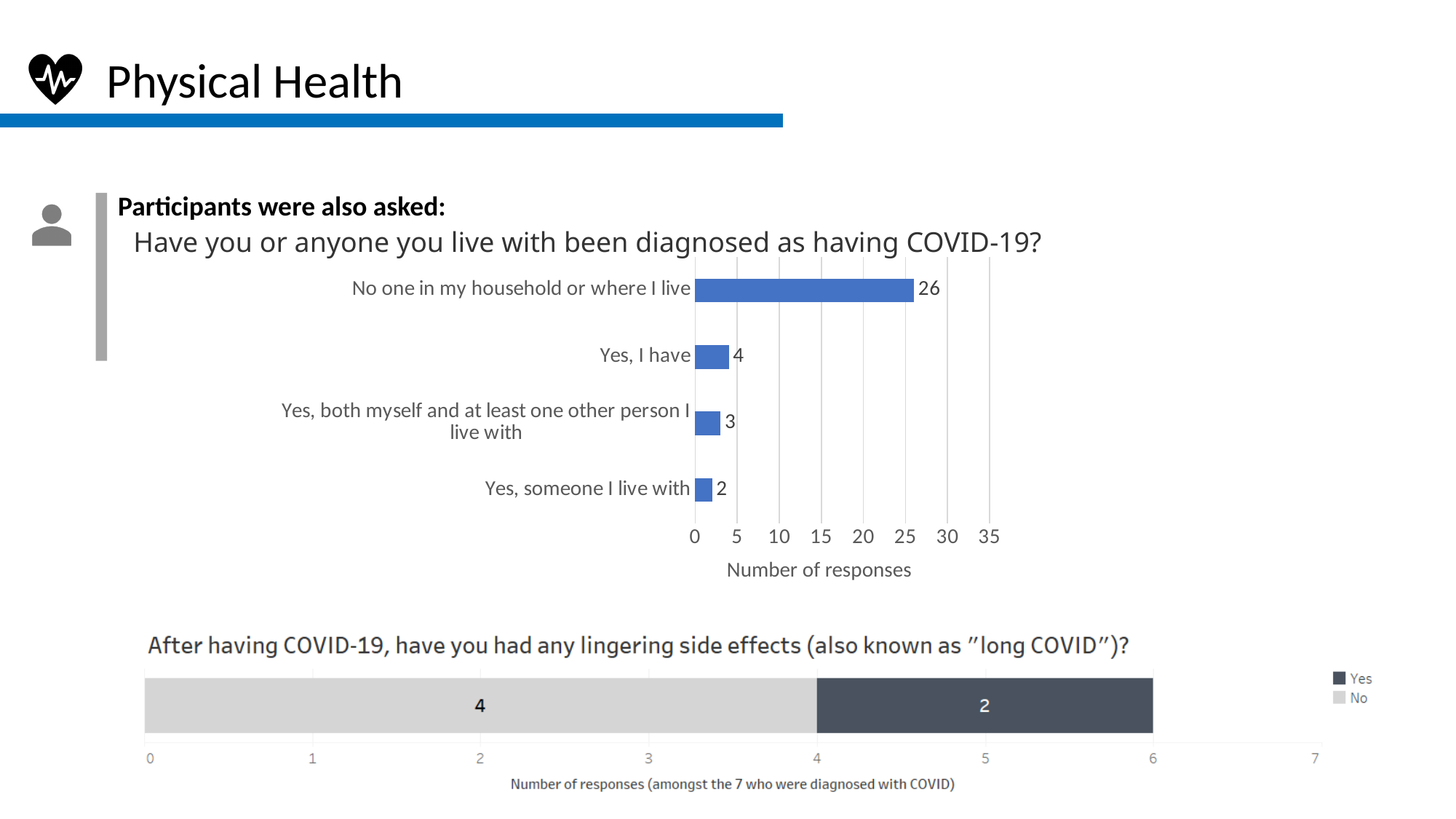
In the chart 'Have you or anyone you live with been diagnosed as having COVID-19?', which category has the highest number of responses? No one in my household or where I live In the chart 'Have you or anyone you live with been diagnosed as having COVID-19?', how many responses were for 'Yes, I have'? 4 In the chart 'Have you or anyone you live with been diagnosed as having COVID-19?', which category has the lowest number of responses? Yes, someone I live with In the chart 'After having COVID-19, have you had any lingering side effects (also known as "long COVID")?', how many series does the legend list? 2 What kind of chart is 'Have you or anyone you live with been diagnosed as having COVID-19?'? bar chart In the chart 'Have you or anyone you live with been diagnosed as having COVID-19?', how many responses were for 'Yes, someone I live with'? 2 In the chart 'Have you or anyone you live with been diagnosed as having COVID-19?', what is the difference between 'No one in my household or where I live' and 'Yes, I have'? 22 In the chart 'After having COVID-19, have you had any lingering side effects (also known as "long COVID")?', how many responses were 'Yes'? 2 In the chart 'After having COVID-19, have you had any lingering side effects (also known as "long COVID")?', how many responses were 'No'? 4 In the chart 'Have you or anyone you live with been diagnosed as having COVID-19?', how many responses were for 'No one in my household or where I live'? 26 In the chart 'Have you or anyone you live with been diagnosed as having COVID-19?', how many categories are shown? 4 In the chart 'After having COVID-19, have you had any lingering side effects (also known as "long COVID")?', what is the total of the stacked bar? 6